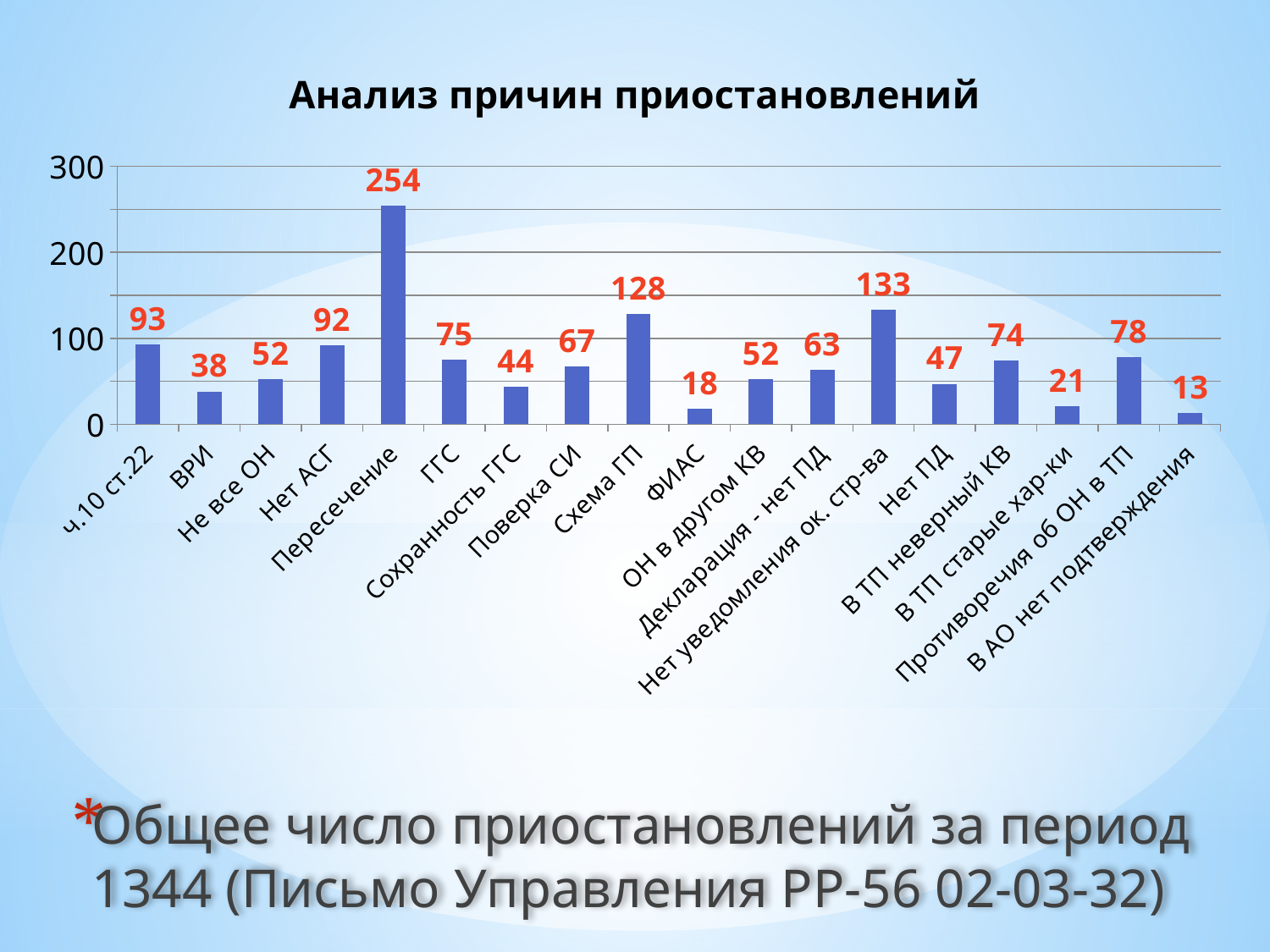
What is the difference between the values for ч.10 ст.22 and ВРИ? 55 Which is larger, the value for ГГС or the value for Поверка СИ? ГГС What is the value for Схема ГП? 128 How many categories are shown on the x axis? 18 Which category has the highest value? Пересечение What is the title of the chart? Анализ причин приостановлений What is the value for Нет уведомления ок. стр-ва? 133 What kind of chart is shown on the slide? Bar chart What is the value for Пересечение? 254 What is the difference between the values for Пересечение and Нет уведомления ок. стр-ва? 121 What is the value for ФИАС? 18 Which category has the lowest value? В АО нет подтверждения